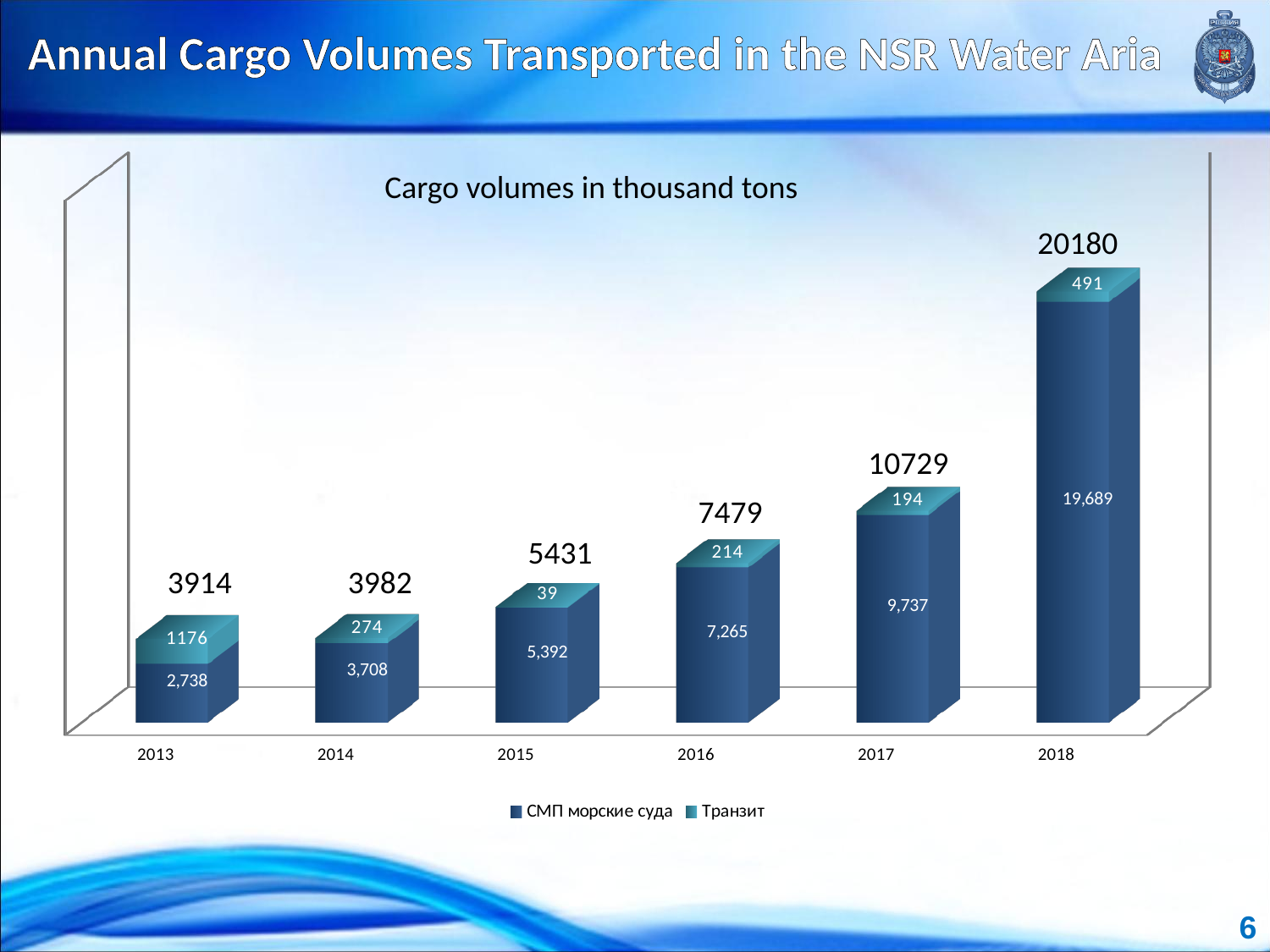
What is the value of Транзит for 2015? 39 What is the total cargo volume shown for 2016? 7479 How many years are shown on the x axis? 6 Which year has the highest total cargo volume? 2018 Is the Транзит value larger in 2014 or in 2016? 2014 What is the difference between the СМП морские суда values for 2018 and 2017? 9,952 What type of chart is shown on the slide? stacked bar chart What is the value of Транзит for 2013? 1176 What is the value of СМП морские суда for 2018? 19,689 What is the value of СМП морские суда for 2016? 7,265 Which year has the lowest Транзит value? 2015 How many series does the legend list? 2